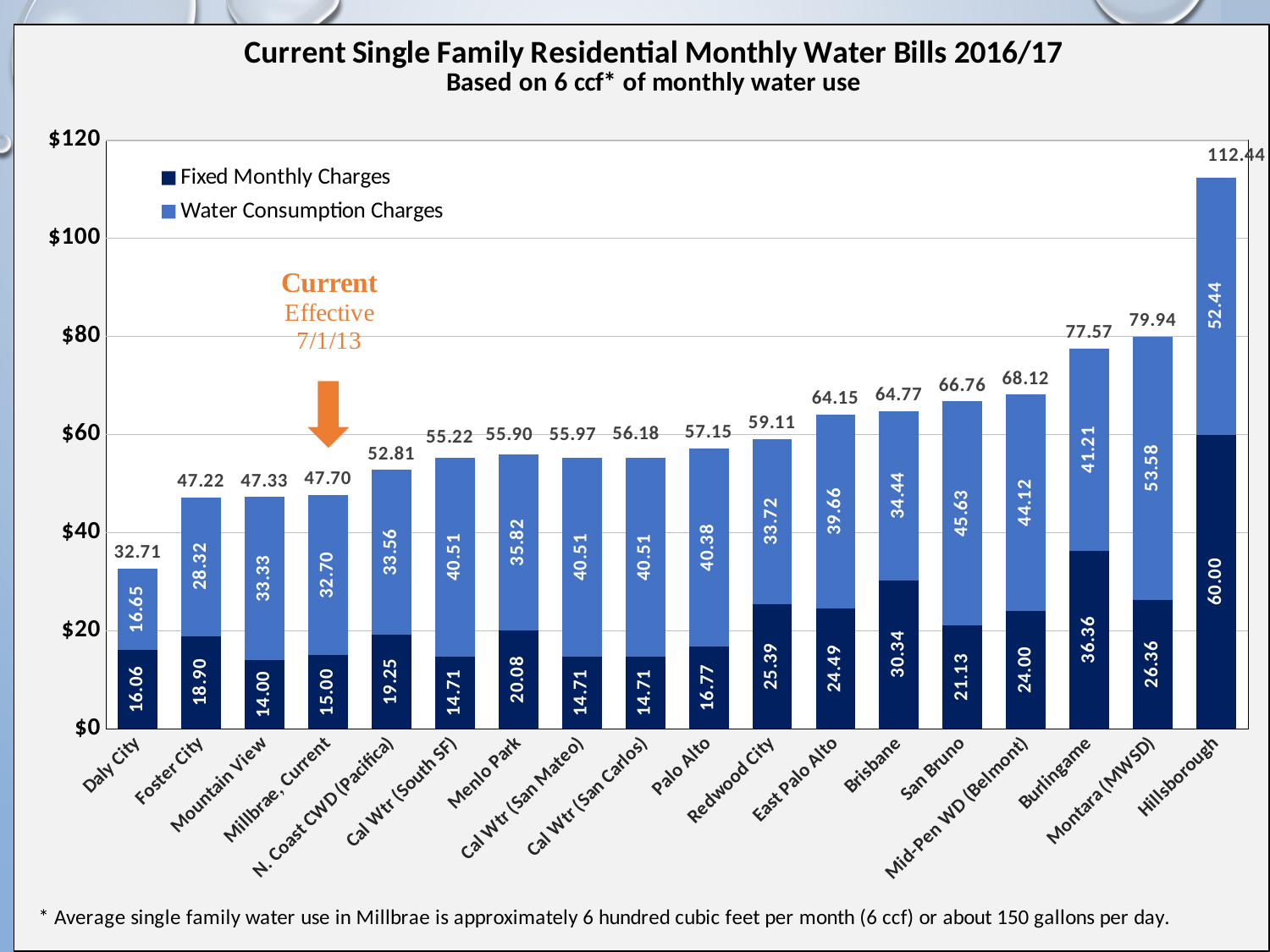
Which has the larger Fixed Monthly Charges value, Burlingame or Brisbane? Burlingame How many agencies (categories) are plotted along the x axis? 18 How many series does the legend list? 2 What is the total monthly water bill shown for Burlingame? 77.57 What kind of chart is shown on the slide? Stacked bar chart What is the Water Consumption Charges value for Montara (MWSD)? 53.58 Which agency has the highest total monthly water bill? Hillsborough Do the total monthly water bills rise or fall from left to right along the x axis? Rise What is the difference between the total bill for Hillsborough and the total bill for Millbrae, Current? 64.74 Is the total bill for San Bruno greater or less than $60? greater What is the Fixed Monthly Charges value for Millbrae, Current? 15.00 Which agency has the lowest total monthly water bill? Daly City